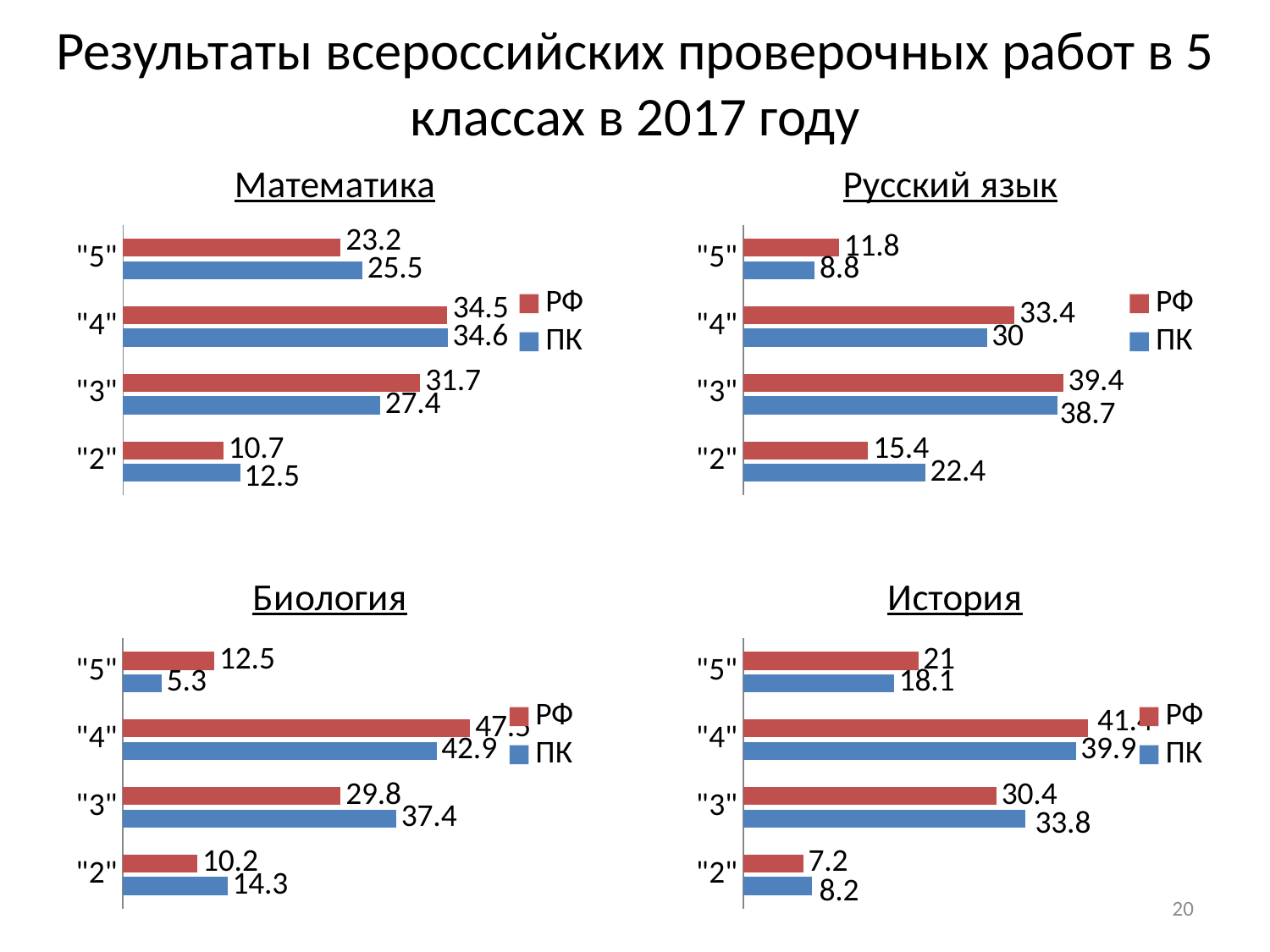
In the Биология chart, what is the value for ПК for grade "5"? 5.3 How many grade categories does the Русский язык chart show? 4 In the Математика chart, what is the difference between the ПК and РФ values for grade "3"? 4.3 In the Русский язык chart, what is the value for ПК for grade "2"? 22.4 In the История chart, which grade has the lowest value for ПК? "2" In the История chart, what is the value for РФ for grade "3"? 30.4 What type of chart is the История chart? Bar chart In the Биология chart, which colour represents the ПК series? Blue In the Биология chart, which is larger for grade "3": РФ or ПК? ПК In the Русский язык chart, which grade has the highest value for РФ? "3" How many series does the legend of the Математика chart list? 2 In the Математика chart, what is the value for РФ for grade "5"? 23.2